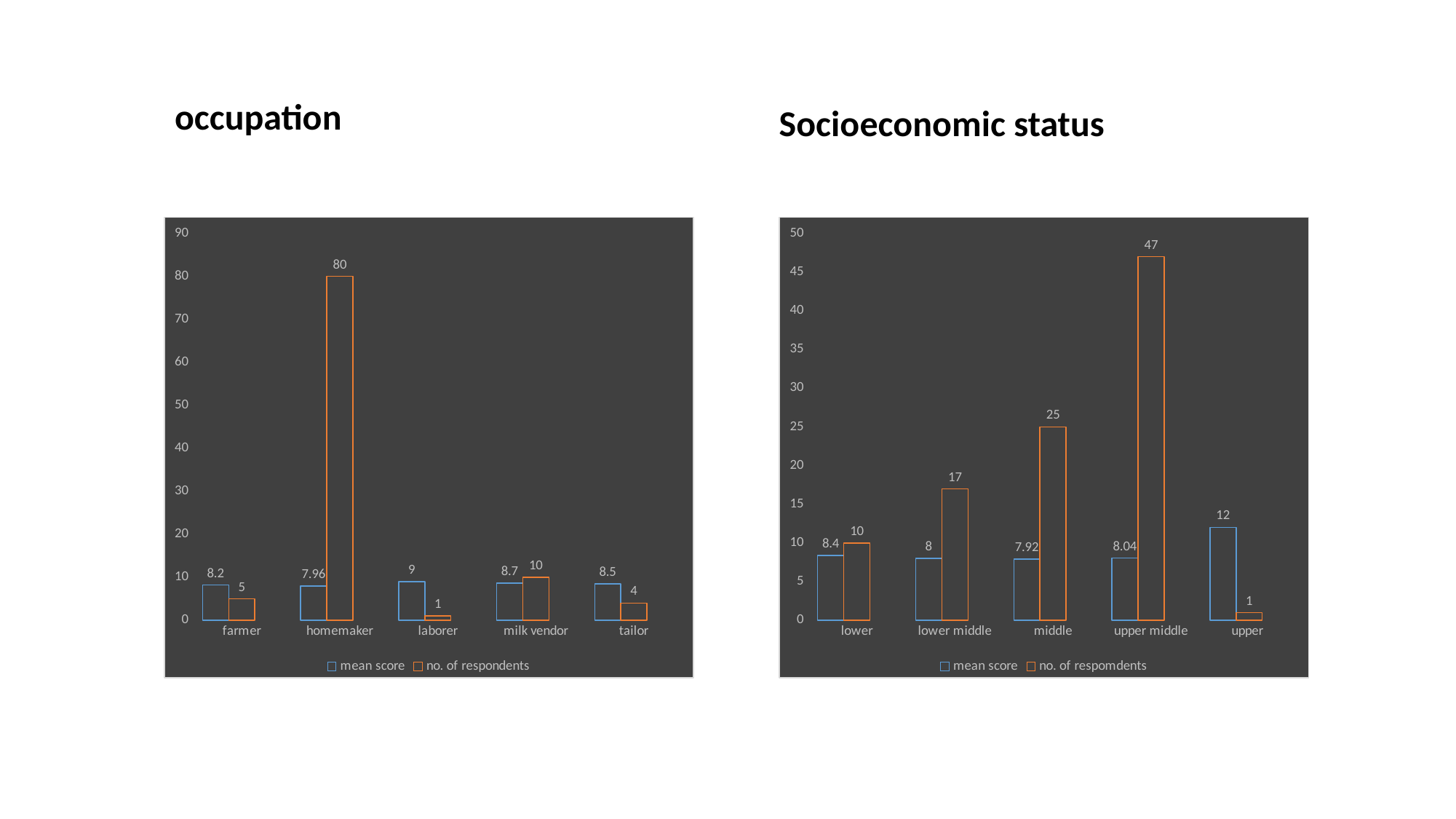
In the occupation chart, which occupation has the lowest number of respondents? laborer In the Socioeconomic status chart, how many series does the legend list? 2 In the occupation chart, which occupation has the highest mean score? laborer What kind of chart is the occupation chart? bar chart In the Socioeconomic status chart, what is the difference in number of respondents between upper middle and middle? 22 In the occupation chart, what is the difference in number of respondents between homemaker and milk vendor? 70 In the Socioeconomic status chart, what is the mean score for middle? 7.92 In the occupation chart, what is the number of respondents for homemaker? 80 In the occupation chart, what is the mean score for milk vendor? 8.7 In the occupation chart, how many occupation categories are shown? 5 In the Socioeconomic status chart, which category has the highest number of respondents? upper middle In the Socioeconomic status chart, which is larger, the mean score for lower or the mean score for upper middle? lower